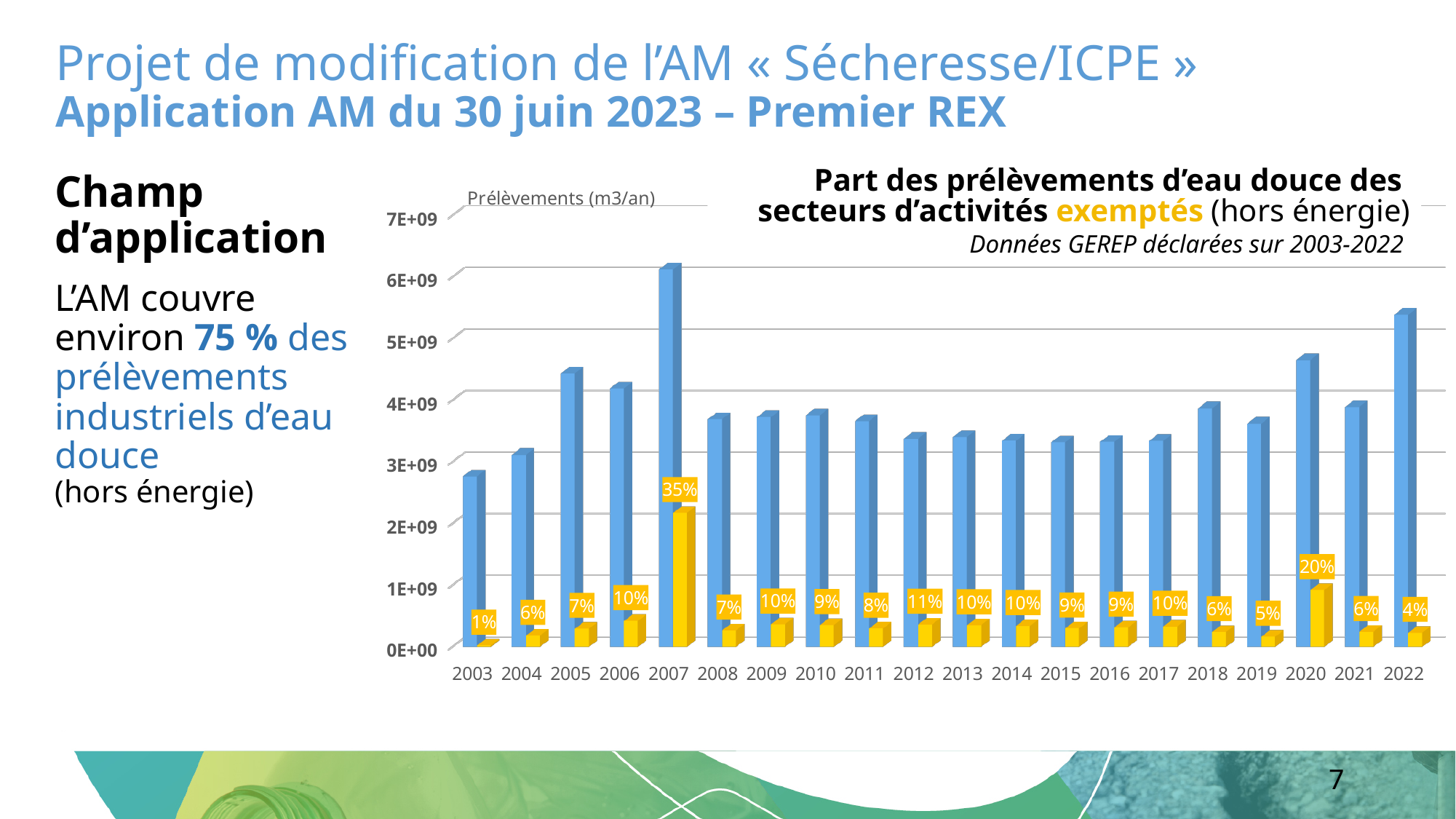
What kind of chart is shown on the slide? Bar chart What percentage label is shown for 2022 in the chart? 4% Is the blue bar for 2003 greater or less than 3E+09? less What percentage label is shown for 2007 in the chart? 35% How many years are shown on the x axis of the chart? 20 Which year has the lowest percentage label in the chart? 2003 What percentage label is shown for 2003 in the chart? 1% Which year has the taller blue bar, 2007 or 2022? 2007 What percentage label is shown for 2020 in the chart? 20% Which year has the highest percentage label in the chart? 2007 What is the difference between the percentage labels for 2007 and 2020? 15 percentage points Is the blue bar for 2007 greater or less than 6E+09? greater